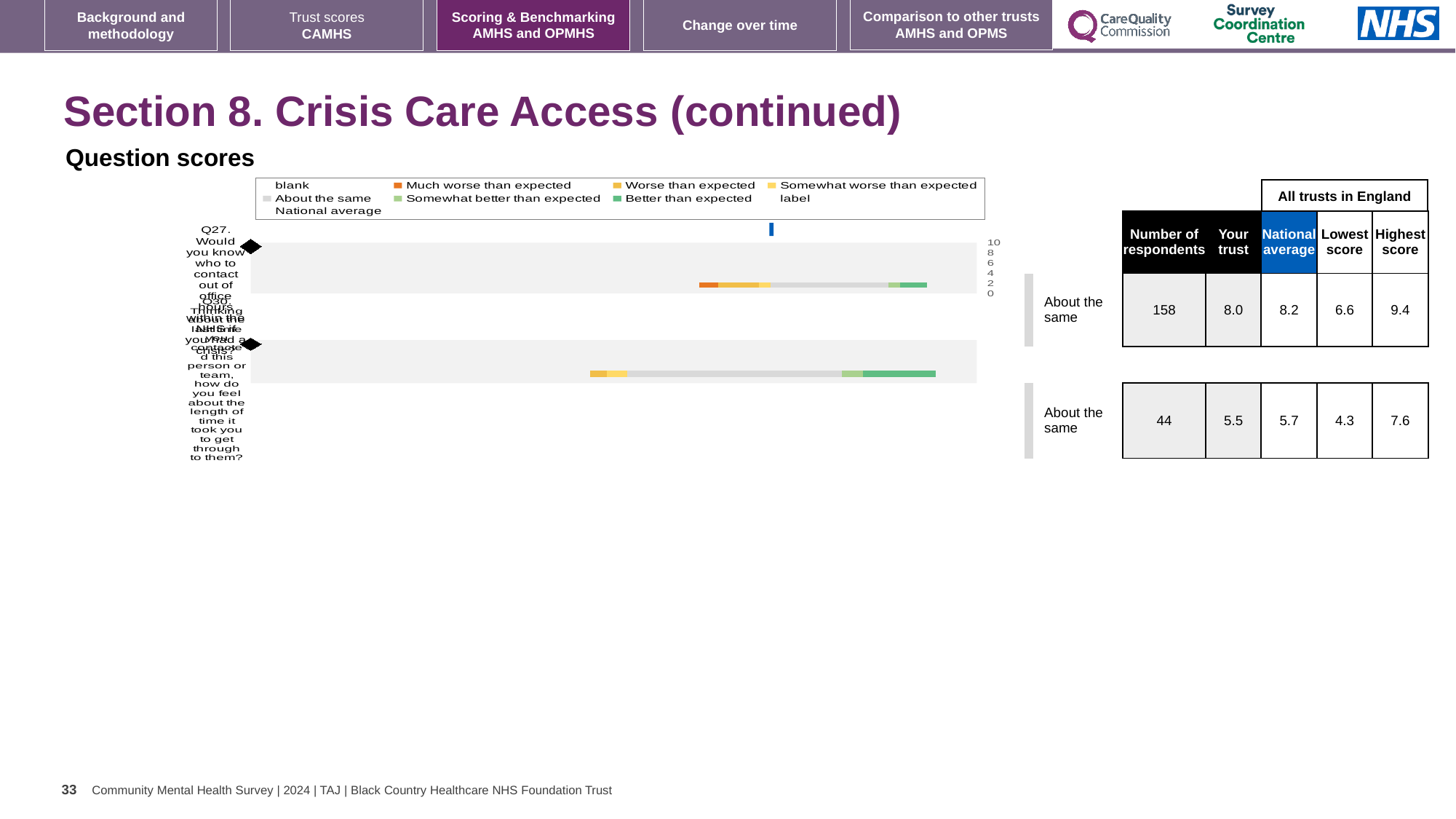
In the table beside the question scores chart, which is larger for Q27: the 'Your trust' score or the national average? national average In the table beside the question scores chart, what is the number of respondents for Q27? 158 In the table beside the question scores chart, what is the difference between the national average and the 'Your trust' score for Q30? 0.2 In the question scores chart legend, what colour represents 'Better than expected'? green How many questions (bars) are plotted in the question scores chart? 2 In the table beside the question scores chart, what is the national average for Q27? 8.2 What kind of chart is used to show the question scores on this slide? bar chart In the table beside the question scores chart, what is the difference between the highest score and the lowest score for Q27? 2.8 In the question scores chart legend, what colour represents 'Much worse than expected'? orange How many entries does the legend of the question scores chart list? 9 In the table beside the question scores chart, what is the highest score for Q30? 7.6 In the table beside the question scores chart, what is the 'Your trust' score for Q30? 5.5